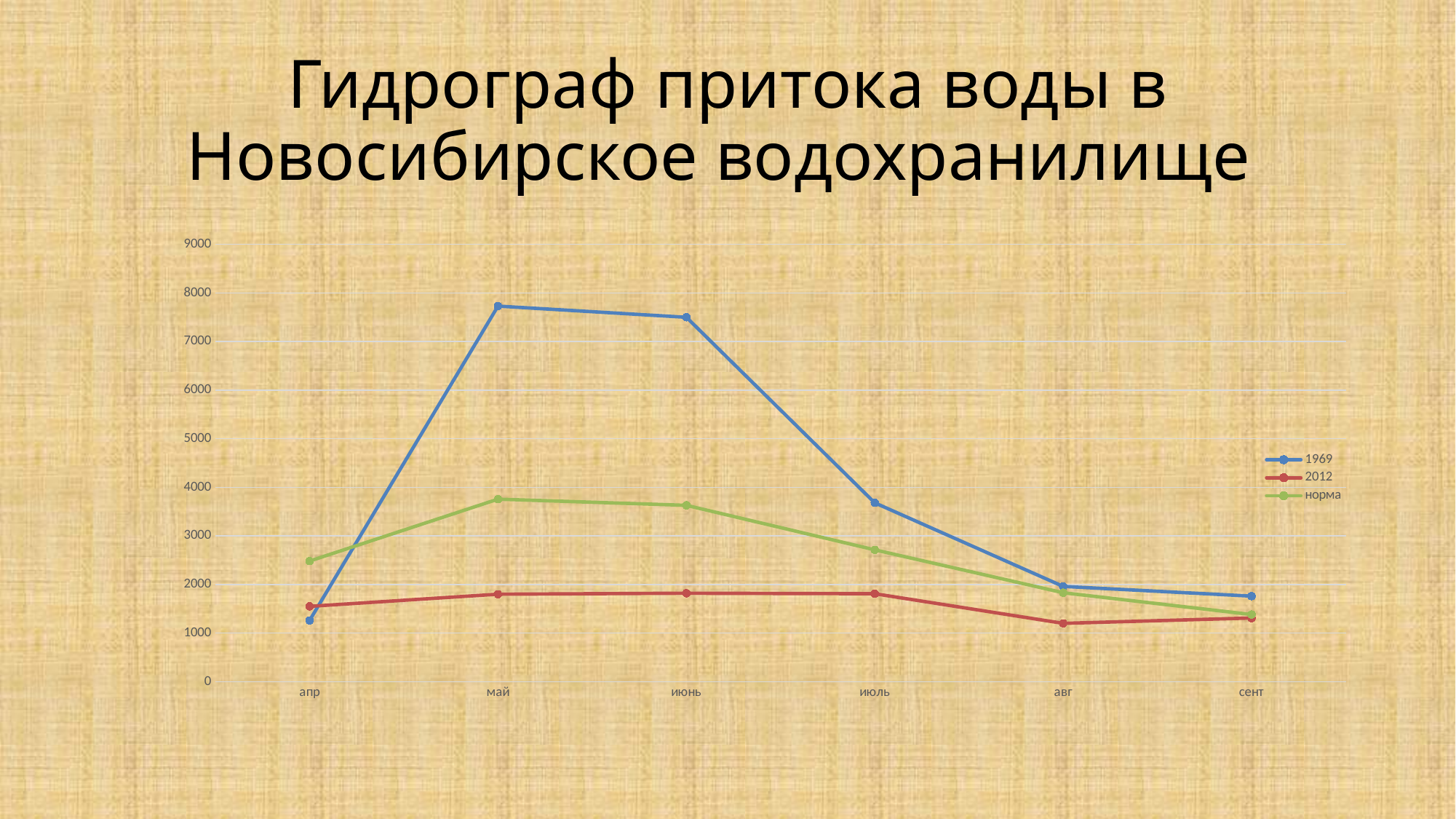
In which month does the 2012 series reach its lowest value? авг In апр, which series has the larger value, 2012 or 1969? 2012 Is the value for 1969 in май greater or less than 7000? greater Which series are listed in the legend? 1969, 2012, норма How many months are shown along the x axis? 6 In which month does the 1969 series reach its highest value? май How many series does the legend list? 3 Does the 1969 series rise or fall from июнь to сент? fall Is the value for норма in май greater or less than 3000? greater What kind of chart is shown on the slide? line chart Is the value for 2012 in авг greater or less than 2000? less In июль, which series has the larger value, 1969 or норма? 1969